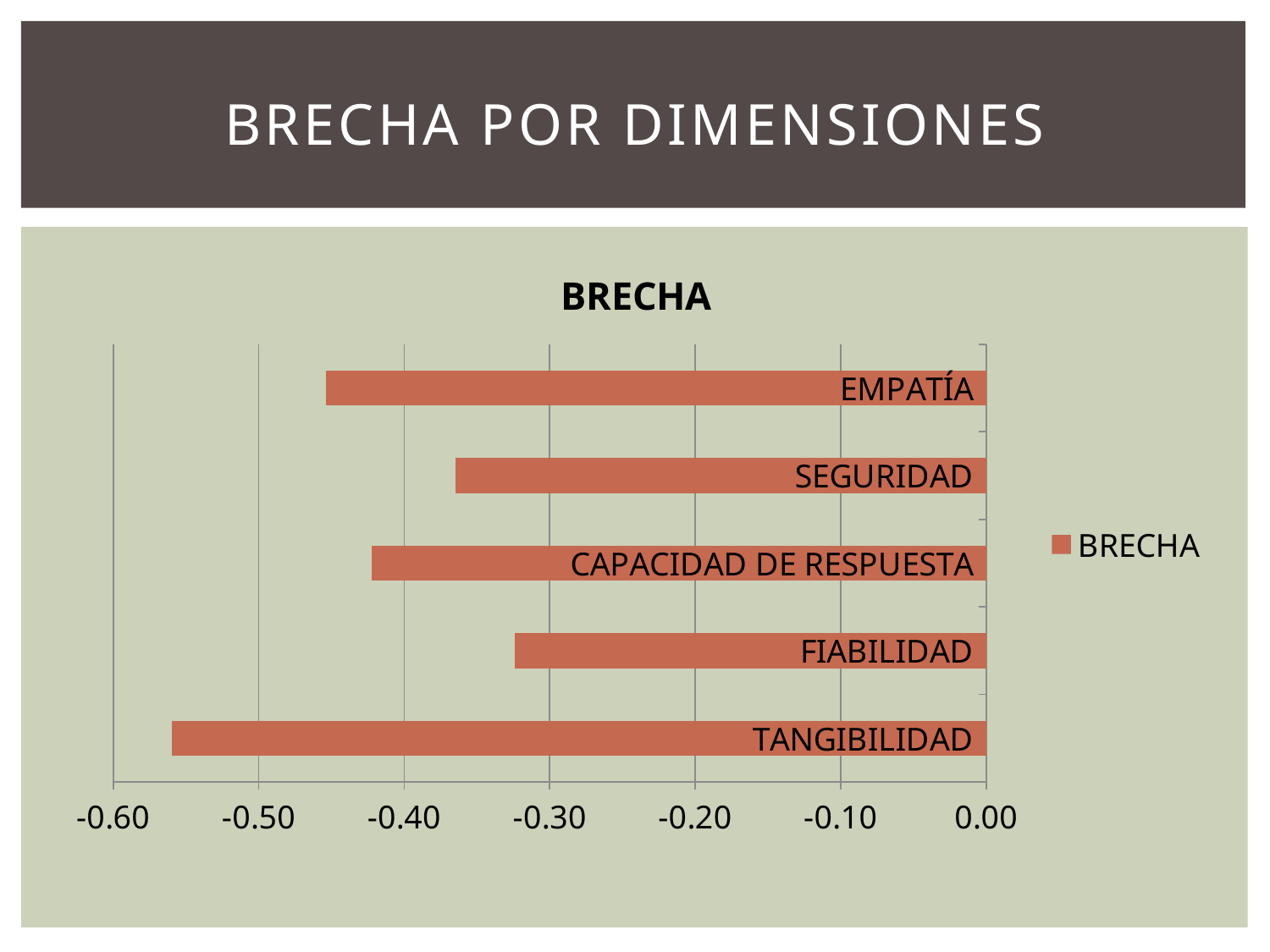
Is the value for EMPATÍA greater or less than -0.40? less Which dimension has the highest value (closest to zero) in the BRECHA chart? FIABILIDAD What is the name of the series shown in the chart legend? BRECHA Which has the lower (more negative) value, TANGIBILIDAD or FIABILIDAD? TANGIBILIDAD Is the value for TANGIBILIDAD greater or less than -0.50? less Is the value for FIABILIDAD greater or less than -0.40? greater How many categories (dimensions) are plotted in the BRECHA chart? 5 How many series does the legend of the BRECHA chart list? 1 Which dimension has the lowest (most negative) value in the BRECHA chart? TANGIBILIDAD What is the title of the chart on the slide? BRECHA Which has the larger (less negative) value, EMPATÍA or SEGURIDAD? SEGURIDAD What type of chart is shown on the slide? bar chart